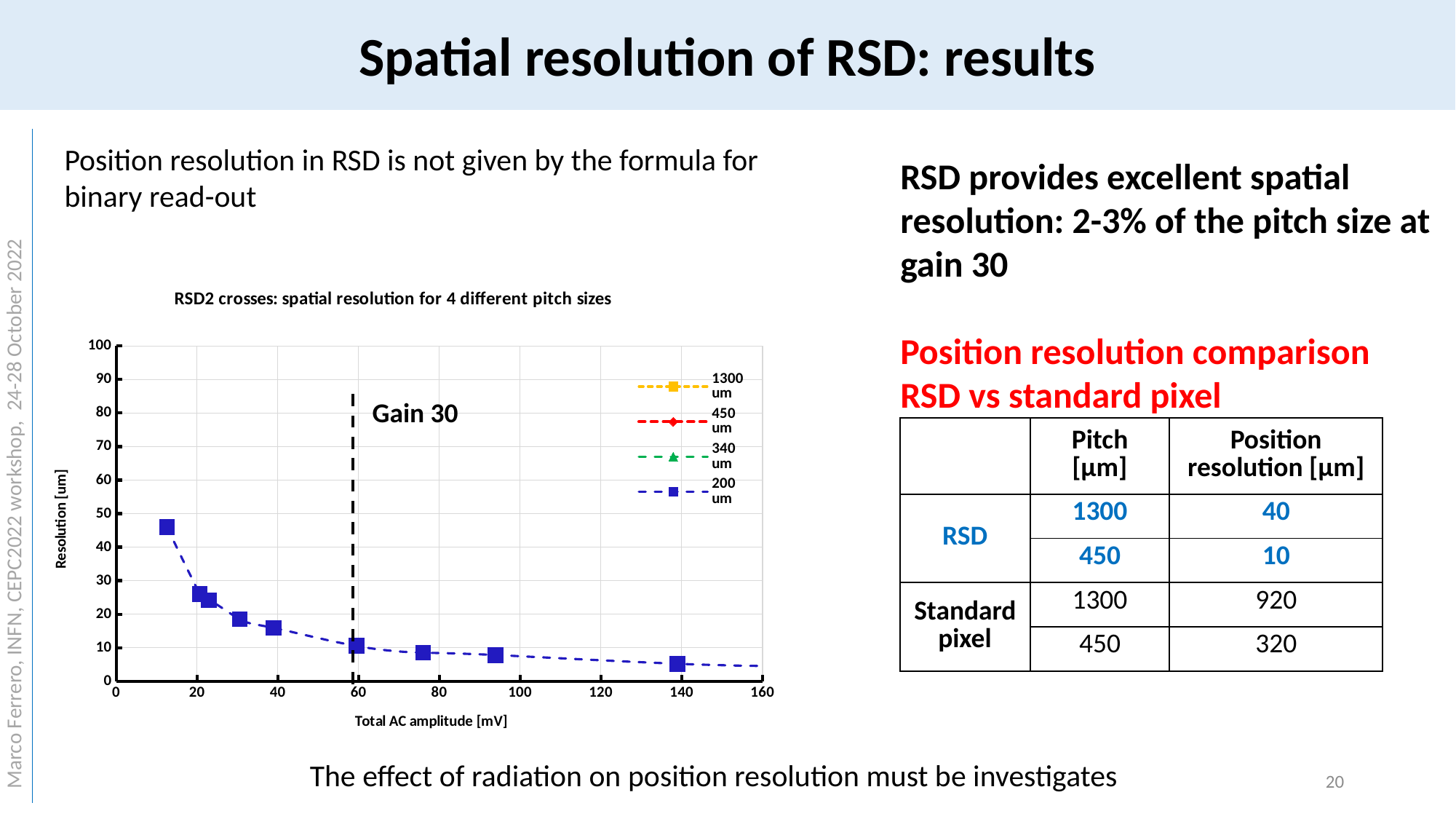
Is the resolution at the point near 12 mV larger or smaller than the resolution at the point near 138 mV? larger Is the resolution at about 94 mV total AC amplitude greater or less than 10 µm? less Is the resolution at the highest plotted AC amplitude (around 140 mV) greater or less than 10 µm? less Does the resolution rise or fall as the total AC amplitude increases? Fall What does the dashed vertical line on the chart mark? Gain 30 Is the resolution at about 20 mV total AC amplitude greater or less than 20 µm? greater Does the highest resolution value occur at the lowest or the highest total AC amplitude? lowest Which series is actually plotted with data points on the chart? 200 um How many series does the legend of the chart list? 4 What kind of chart is shown on the slide? Scatter (line) chart How many data points are plotted for the 200 um series? 9